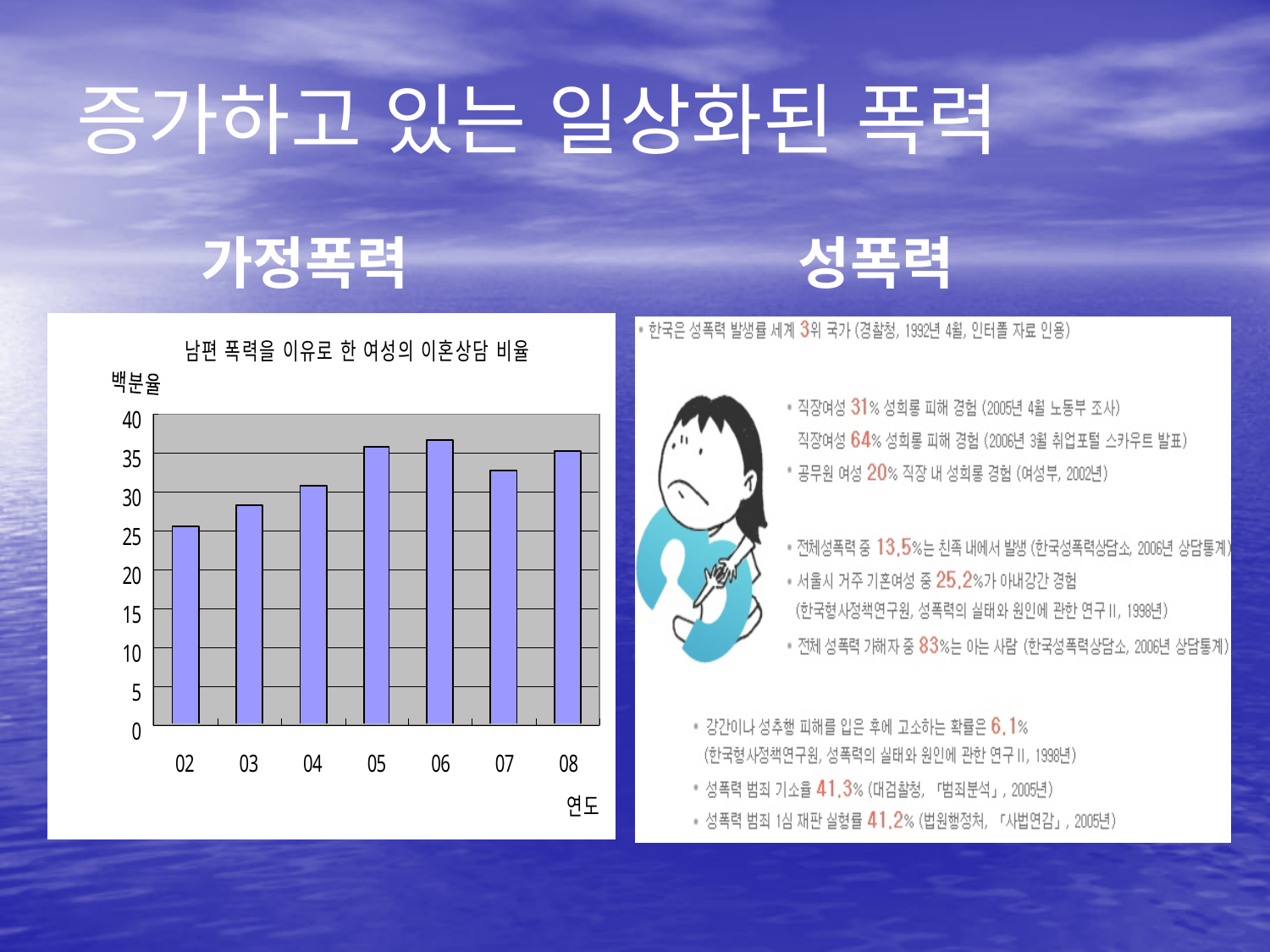
What kind of chart is shown on the left side of the slide under 가정폭력? bar chart Which year has the lowest bar in the chart? 02 Which year has the larger value, 05 or 07? 05 Is the value for 07 greater or less than 30? greater How many years (bars) are plotted in the bar chart? 7 Is the value for 03 greater or less than 30? less Which year has the highest bar in the chart? 06 Is the value for 06 greater or less than 35? greater What is the title of the bar chart on the left? 남편 폭력을 이유로 한 여성의 이혼상담 비율 Do the values rise or fall from 02 to 06? rise Which year has the larger value, 02 or 08? 08